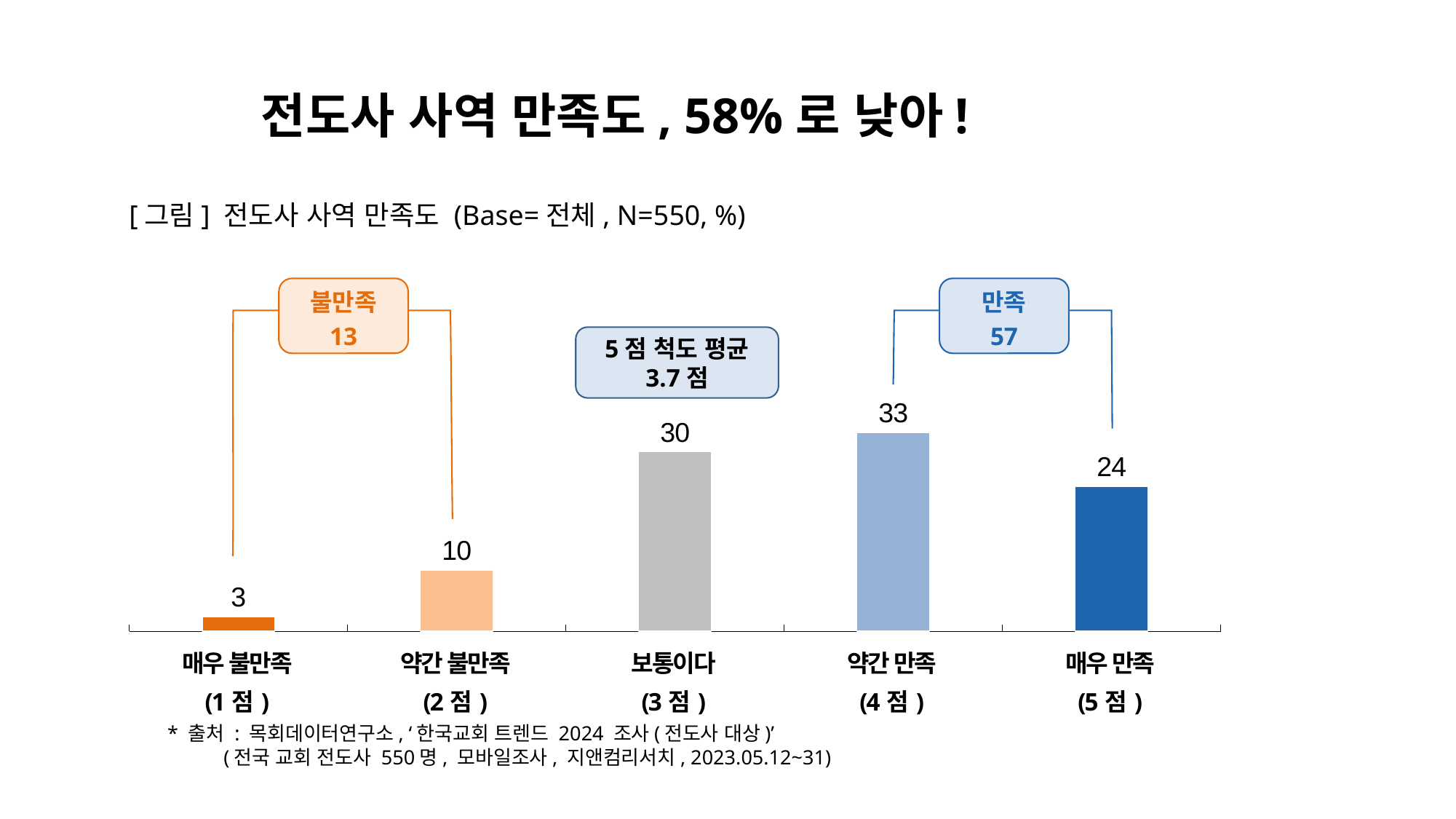
What is the value for 약간 만족 (4점)? 33 What kind of chart is shown on the slide? bar chart What is the value for 약간 불만족 (2점)? 10 What is the 5점 척도 평균 (5-point scale average) shown in the callout on the chart? 3.7점 How many categories are shown in the chart? 5 What is the difference between the values for 약간 만족 (4점) and 매우 만족 (5점)? 9 What is the value for 보통이다 (3점)? 30 Which category has the lowest value? 매우 불만족 (1점) What is the value for 매우 만족 (5점)? 24 Which category has the highest value? 약간 만족 (4점) What is the value for 매우 불만족 (1점)? 3 Which is larger, the value for 보통이다 (3점) or 매우 만족 (5점)? 보통이다 (3점)